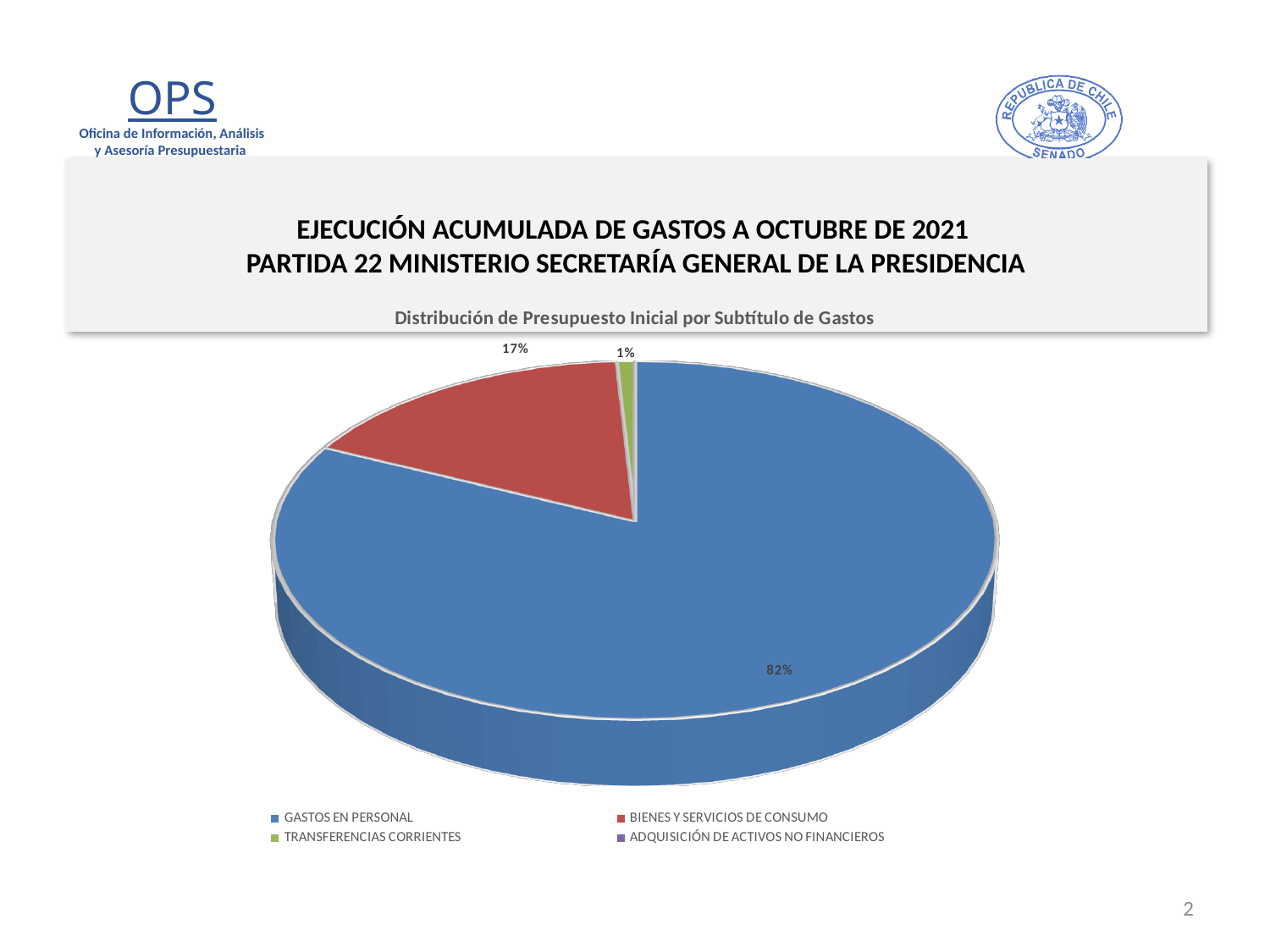
What share of the pie does GASTOS EN PERSONAL represent? 82% What share of the pie does BIENES Y SERVICIOS DE CONSUMO represent? 17% What is the difference in percentage points between the GASTOS EN PERSONAL slice and the BIENES Y SERVICIOS DE CONSUMO slice? 65 percentage points Which of the labeled slices is the smallest? TRANSFERENCIAS CORRIENTES What colour is the GASTOS EN PERSONAL slice? blue How many entries does the legend list? 4 What share of the pie does TRANSFERENCIAS CORRIENTES represent? 1% Which category has the largest slice of the pie? GASTOS EN PERSONAL What kind of chart is shown on the slide? pie chart Which is larger, the BIENES Y SERVICIOS DE CONSUMO slice or the TRANSFERENCIAS CORRIENTES slice? BIENES Y SERVICIOS DE CONSUMO What is the title of the chart? Distribución de Presupuesto Inicial por Subtítulo de Gastos How many percentage labels are printed on the pie? 3